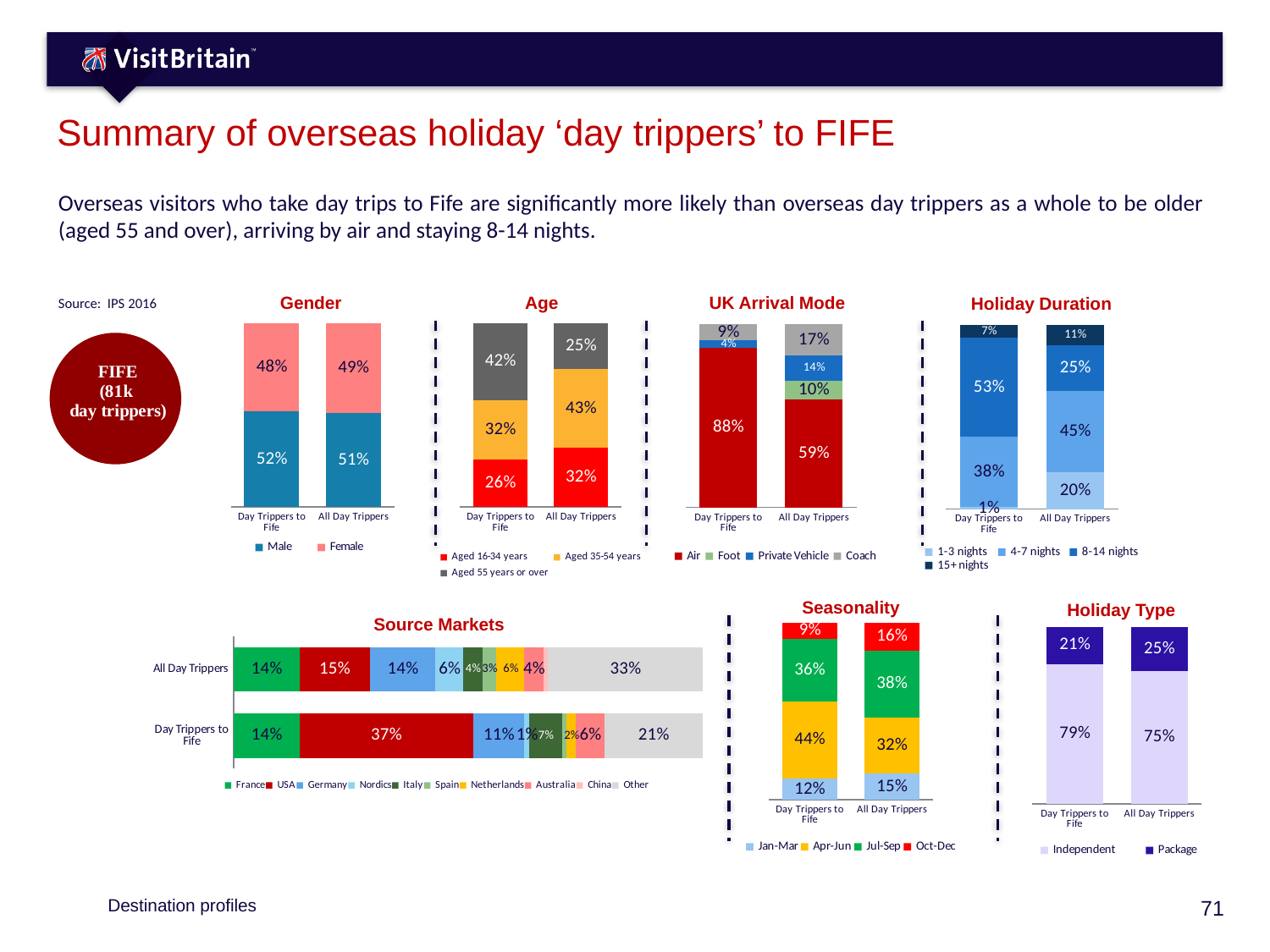
In the Seasonality chart, which quarter has the highest share for Day Trippers to Fife? Apr-Jun In the UK Arrival Mode chart, what percentage of Day Trippers to Fife arrive by Air? 88% In the Source Markets chart, how many source market series does the legend list? 10 In the Age chart, what share of Day Trippers to Fife are Aged 55 years or over? 42% In the Age chart, what is the difference between the Aged 55 years or over share for Day Trippers to Fife and for All Day Trippers? 17 percentage points In the Source Markets chart, what percentage of Day Trippers to Fife come from the USA? 37% In the UK Arrival Mode chart, which arrival mode is the largest for All Day Trippers? Air What type of chart is the Seasonality chart? Stacked bar chart In the Holiday Duration chart, which group has the larger share staying 1-3 nights, Day Trippers to Fife or All Day Trippers? All Day Trippers In the Gender chart, what percentage of Day Trippers to Fife are Male? 52% In the Holiday Duration chart, what percentage of Day Trippers to Fife stay 8-14 nights? 53% In the Holiday Type chart, what percentage of All Day Trippers take a Package holiday? 25%